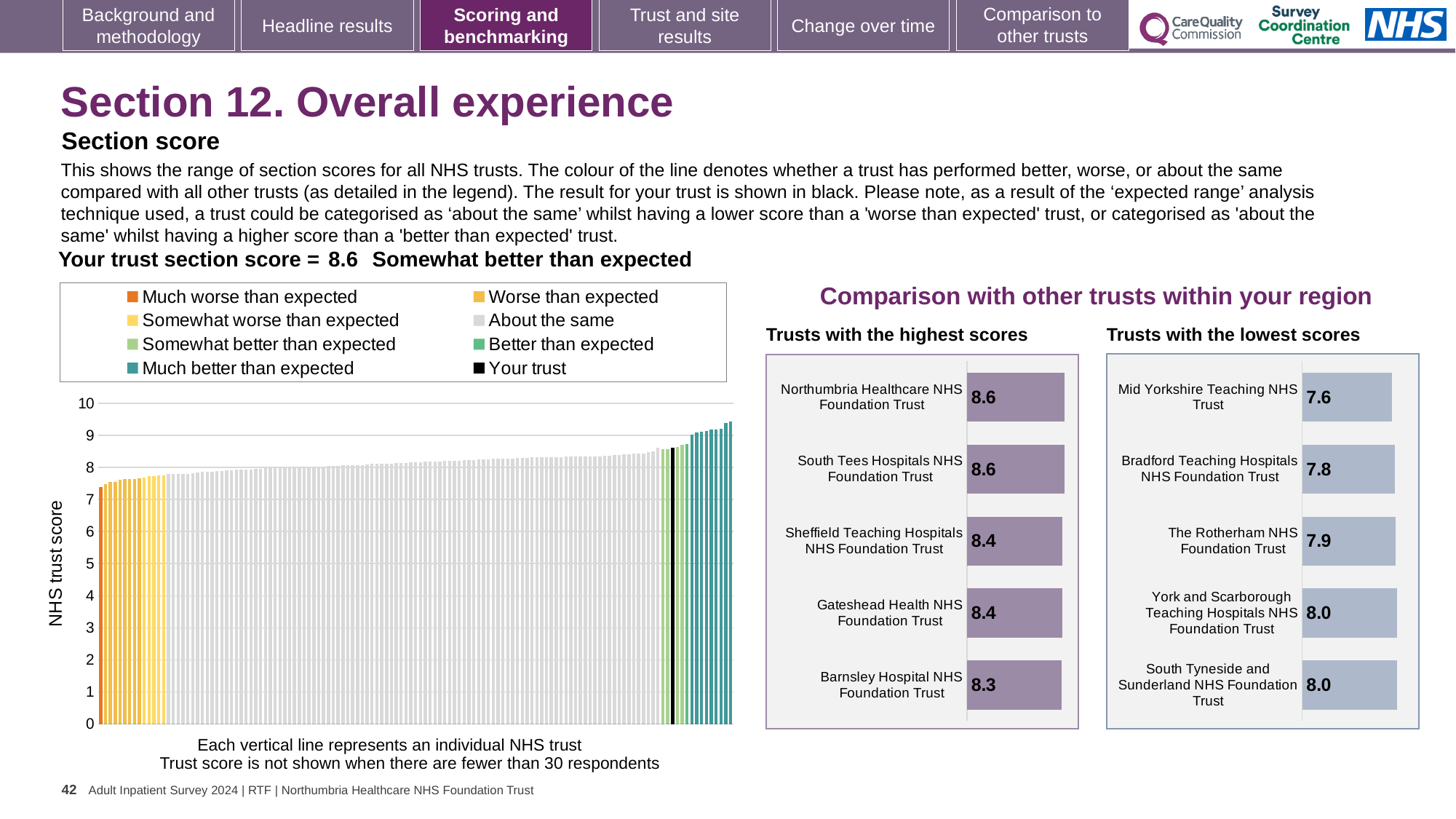
In the 'Trusts with the highest scores' chart, what is the difference between the scores of Northumbria Healthcare NHS Foundation Trust and Barnsley Hospital NHS Foundation Trust? 0.3 In the 'Trusts with the lowest scores' chart, which has the higher score: The Rotherham NHS Foundation Trust or Bradford Teaching Hospitals NHS Foundation Trust? The Rotherham NHS Foundation Trust How many entries does the legend of the main NHS trust score chart list? 8 In the main NHS trust score chart, is the value of the leftmost (lowest-scoring) trust greater or less than 8? less In the 'Trusts with the lowest scores' chart, what is the difference between the scores of Bradford Teaching Hospitals NHS Foundation Trust and Mid Yorkshire Teaching NHS Trust? 0.2 In the 'Trusts with the highest scores' chart, what is the score for Sheffield Teaching Hospitals NHS Foundation Trust? 8.4 What is the section score for your trust shown above the main NHS trust score chart? 8.6 How many trusts are shown in the 'Trusts with the highest scores' chart? 5 In the 'Trusts with the lowest scores' chart, which trust has the lowest score? Mid Yorkshire Teaching NHS Trust In the 'Trusts with the lowest scores' chart, what is the score for Mid Yorkshire Teaching NHS Trust? 7.6 What kind of chart is the 'Trusts with the lowest scores' chart? Bar chart In the main NHS trust score chart, do the bar values rise or fall from left to right? Rise